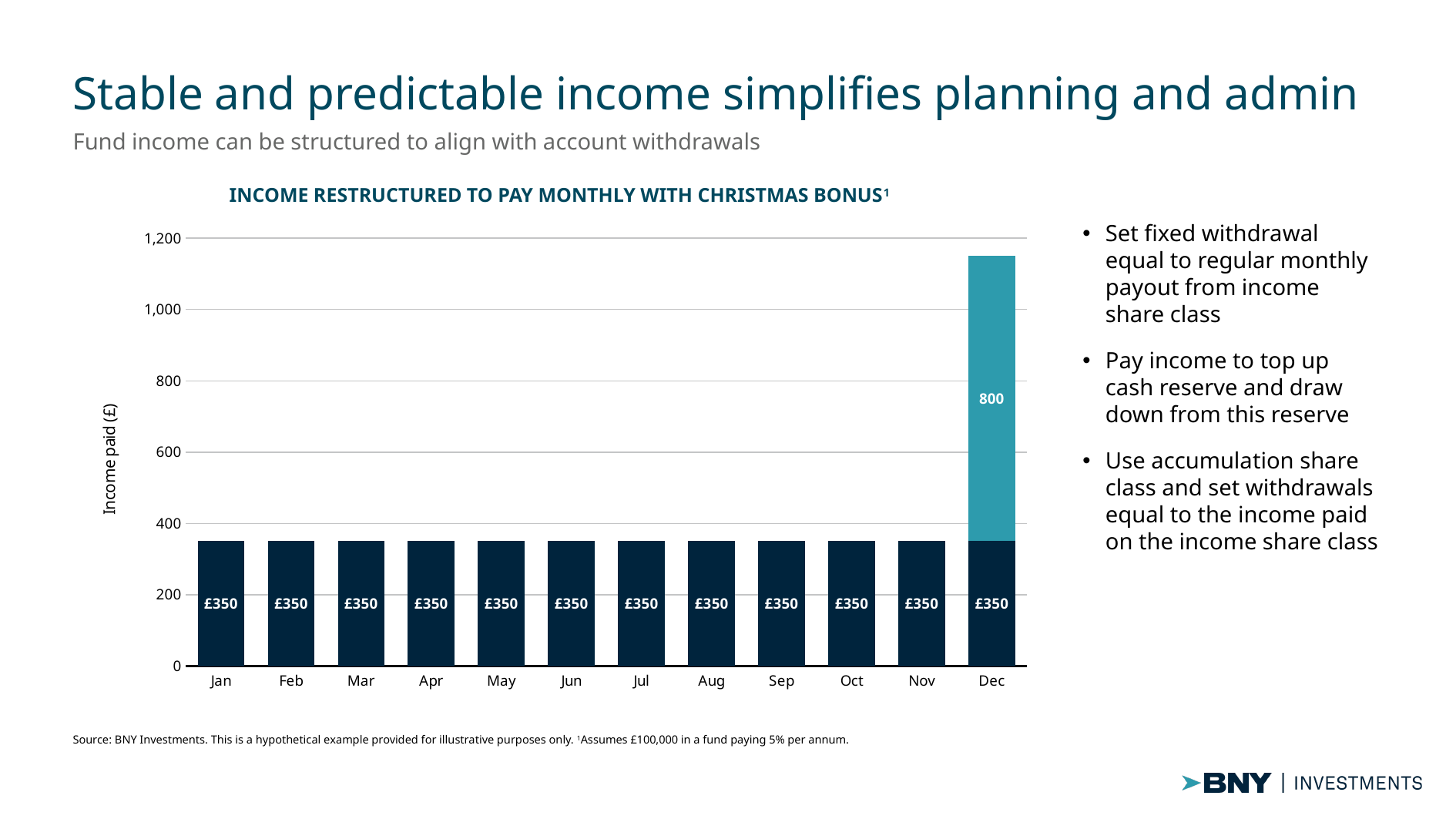
How much larger is the Dec bonus segment (800) than the regular monthly payout of £350? 450 What kind of chart is shown on the slide? Bar chart What is the label on the y axis of the chart? Income paid (£) What is the total income paid in Dec, adding both segments of the stacked bar? £1,150 Which month has the highest total income paid? Dec What is the title of the chart? INCOME RESTRUCTURED TO PAY MONTHLY WITH CHRISTMAS BONUS How many months are shown on the x axis? 12 What is the value of the lower segment of the Dec bar? £350 What is the value of the upper (bonus) segment of the Dec bar? 800 Which month has a larger total income paid, Nov or Dec? Dec What is the income paid in Jan? £350 Is the total value for Dec greater or less than 1,000? greater